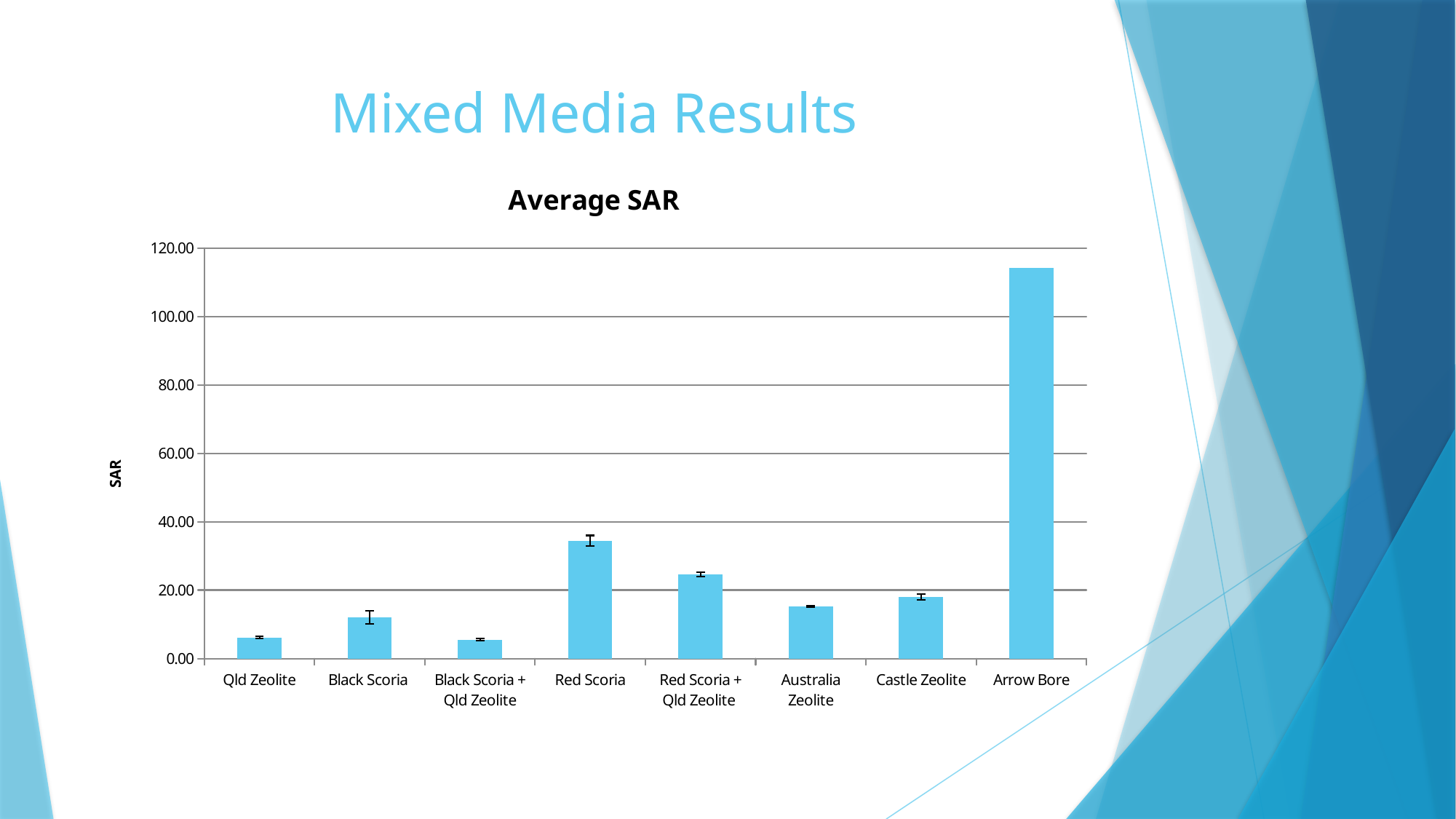
Which category has the highest Average SAR? Arrow Bore Is the value for Red Scoria + Qld Zeolite greater or less than 20.00? greater Is the value for Arrow Bore greater or less than 100.00? greater What is the title of the chart? Average SAR What is the label on the vertical axis of the chart? SAR Is the value for Red Scoria greater or less than 40.00? less How many categories are plotted in the Average SAR chart? 8 Which has a higher Average SAR, Red Scoria or Red Scoria + Qld Zeolite? Red Scoria What type of chart is shown on the slide? Bar chart Which has a higher Average SAR, Black Scoria or Castle Zeolite? Castle Zeolite Which has a higher Average SAR, Australia Zeolite or Black Scoria + Qld Zeolite? Australia Zeolite